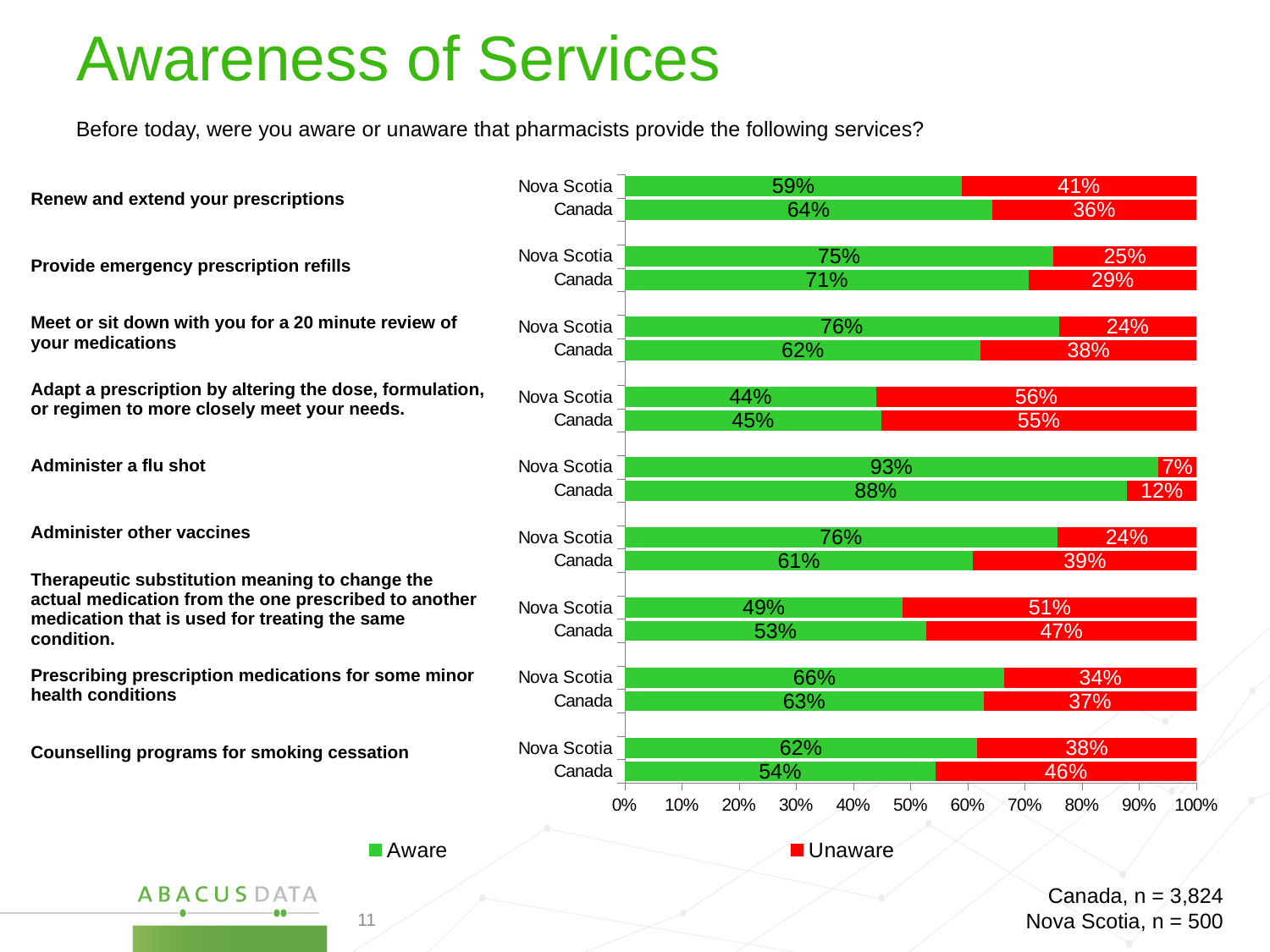
What type of chart is shown on the slide? Stacked bar chart What percentage of Nova Scotia respondents were aware that pharmacists administer a flu shot? 93% For 'Therapeutic substitution', which has the higher Aware value, Nova Scotia or Canada? Canada What percentage of Canada respondents were unaware that pharmacists can renew and extend prescriptions? 36% What is the total of the Aware and Unaware values for the Canada bar for 'Administer a flu shot'? 100% For 'Provide emergency prescription refills', which has the higher Aware value, Nova Scotia or Canada? Nova Scotia Which service has the highest Aware percentage for Nova Scotia? Administer a flu shot Which service has the lowest Aware percentage for Nova Scotia? Adapt a prescription by altering the dose, formulation, or regimen to more closely meet your needs. What colour represents the Unaware series? Red What is the Aware value for Canada for 'Counselling programs for smoking cessation'? 54% How many series does the legend list? 2 What is the difference between the Nova Scotia and Canada Aware values for 'Administer other vaccines'? 15%